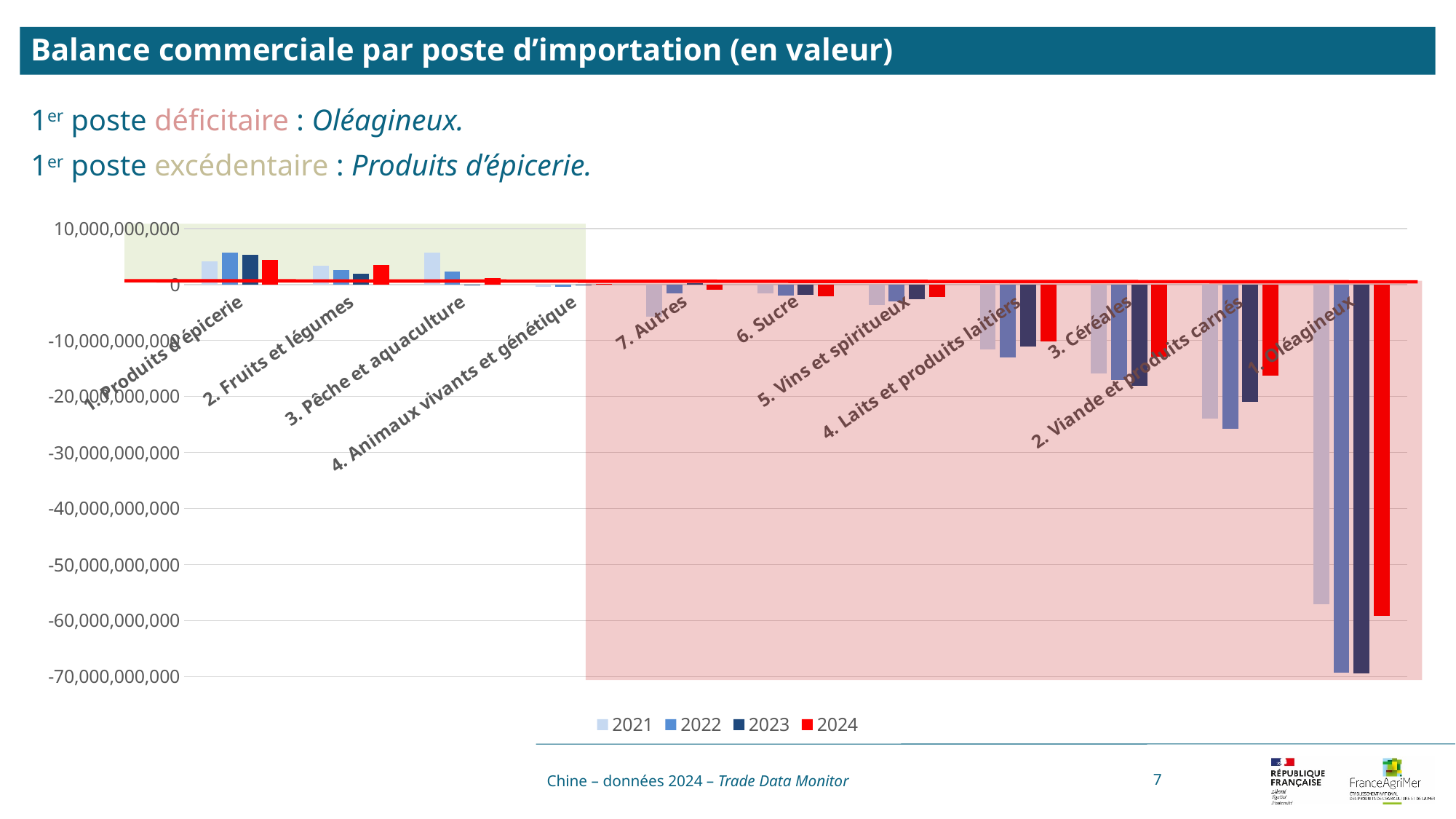
Which category has the lowest (most negative) values in the chart? 1. Oléagineux Is the 2024 value for 1. Oléagineux greater or less than -50,000,000,000? less Which is larger, the 2023 value for 3. Céréales or the 2023 value for 4. Laits et produits laitiers? 4. Laits et produits laitiers Which is larger, the 2024 value for 1. Oléagineux or the 2024 value for 2. Viande et produits carnés? 2. Viande et produits carnés Which colour represents the 2024 series in the chart legend? red Is the 2022 value for 1. Produits d'épicerie greater or less than 10,000,000,000? less Is the 2022 value for 2. Viande et produits carnés greater or less than -20,000,000,000? less How many categories are shown on the x axis of the chart? 11 What kind of chart is shown on the slide? bar chart How many series does the chart legend list? 4